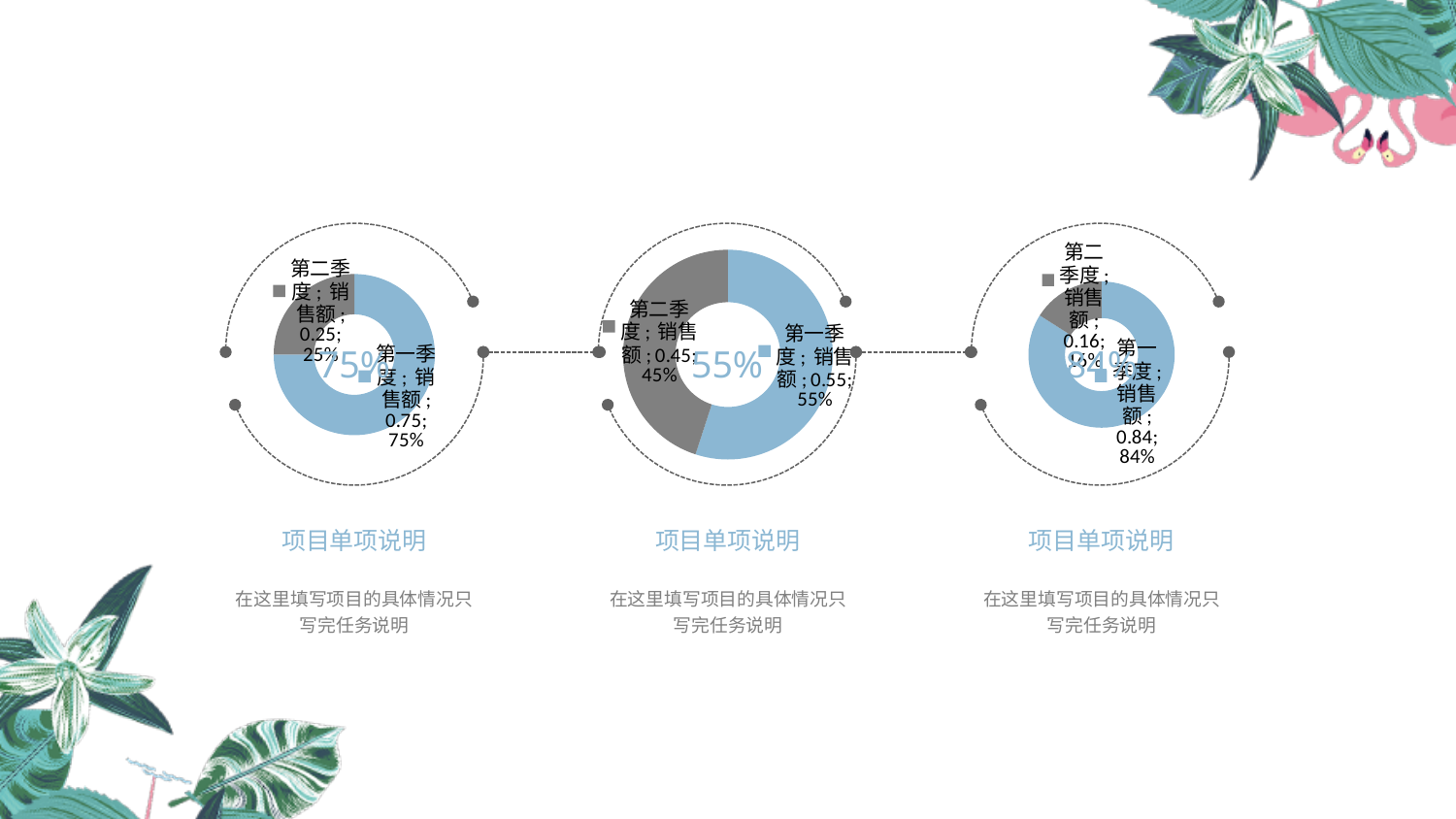
In the middle chart, what value is shown for 第一季度 销售额? 0.55 What percentage is printed in the centre of the right chart? 84% What kind of chart is the left chart on the slide? doughnut chart In the right chart, what percentage is shown for 第一季度 销售额? 84% In the right chart, which category has the smallest slice? 第二季度 In the left chart, what value is shown for 第二季度 销售额? 0.25 In the middle chart, which slice is larger, 第一季度 or 第二季度? 第一季度 In the left chart, what is the difference in percentage points between 第一季度 and 第二季度? 50% In the left chart, what percentage is shown for 第一季度 销售额? 75% How many slices does the middle chart have? 2 In the middle chart, what percentage is shown for 第二季度 销售额? 45% In the right chart, what value is shown for 第二季度 销售额? 0.16